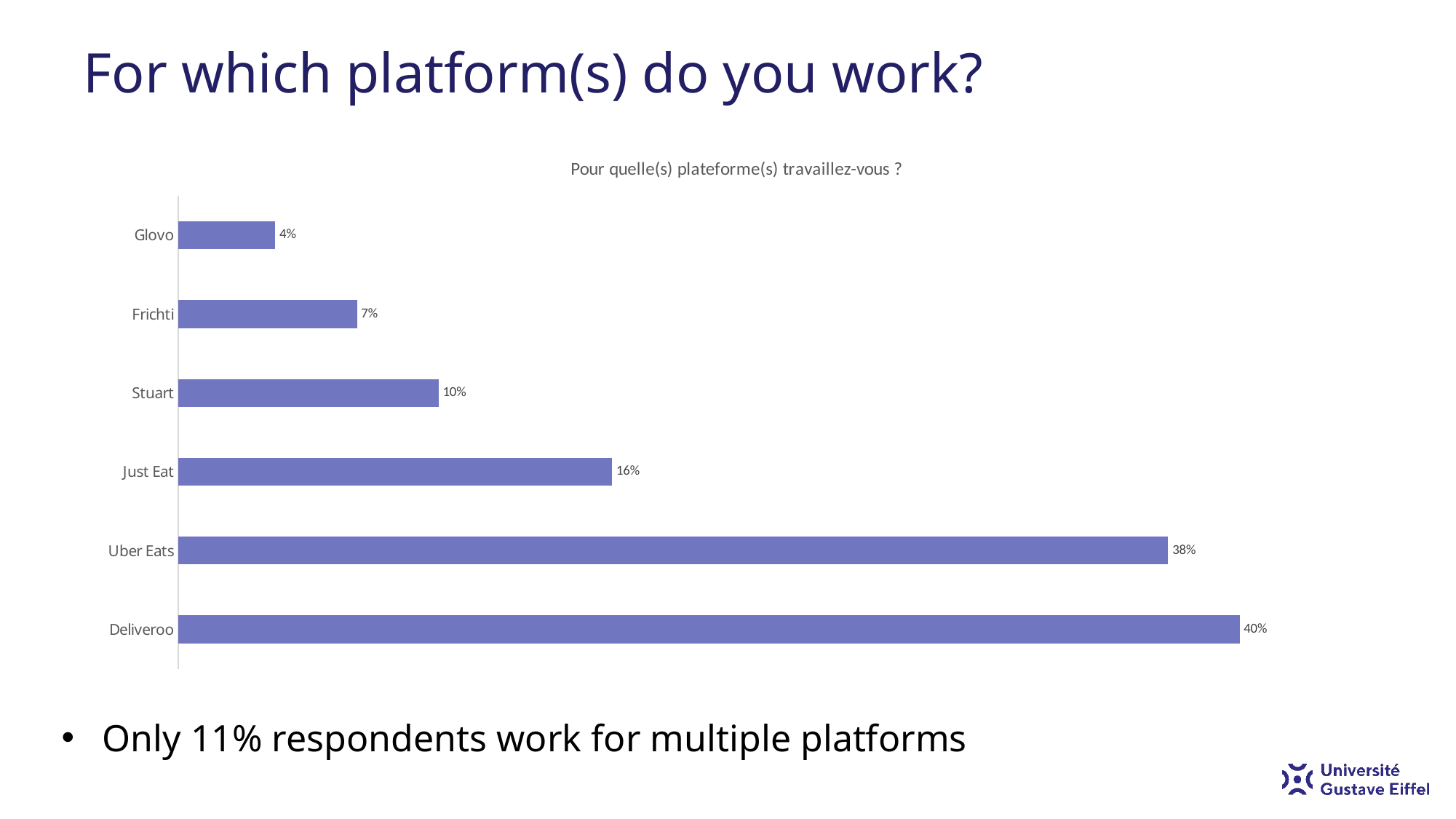
What percentage of respondents work for Uber Eats? 38% What is the value shown for Just Eat? 16% Which has a larger value, Just Eat or Stuart? Just Eat What is the difference in percentage points between Deliveroo and Uber Eats? 2 What is the value shown for Frichti? 7% How many platforms are shown in the chart? 6 What type of chart is shown on the slide? Bar chart What is the value shown for Stuart? 10% What percentage of respondents work for Deliveroo? 40% Which platform has the highest percentage of respondents? Deliveroo Which platform has the lowest percentage of respondents? Glovo What is the title of the chart? Pour quelle(s) plateforme(s) travaillez-vous ?